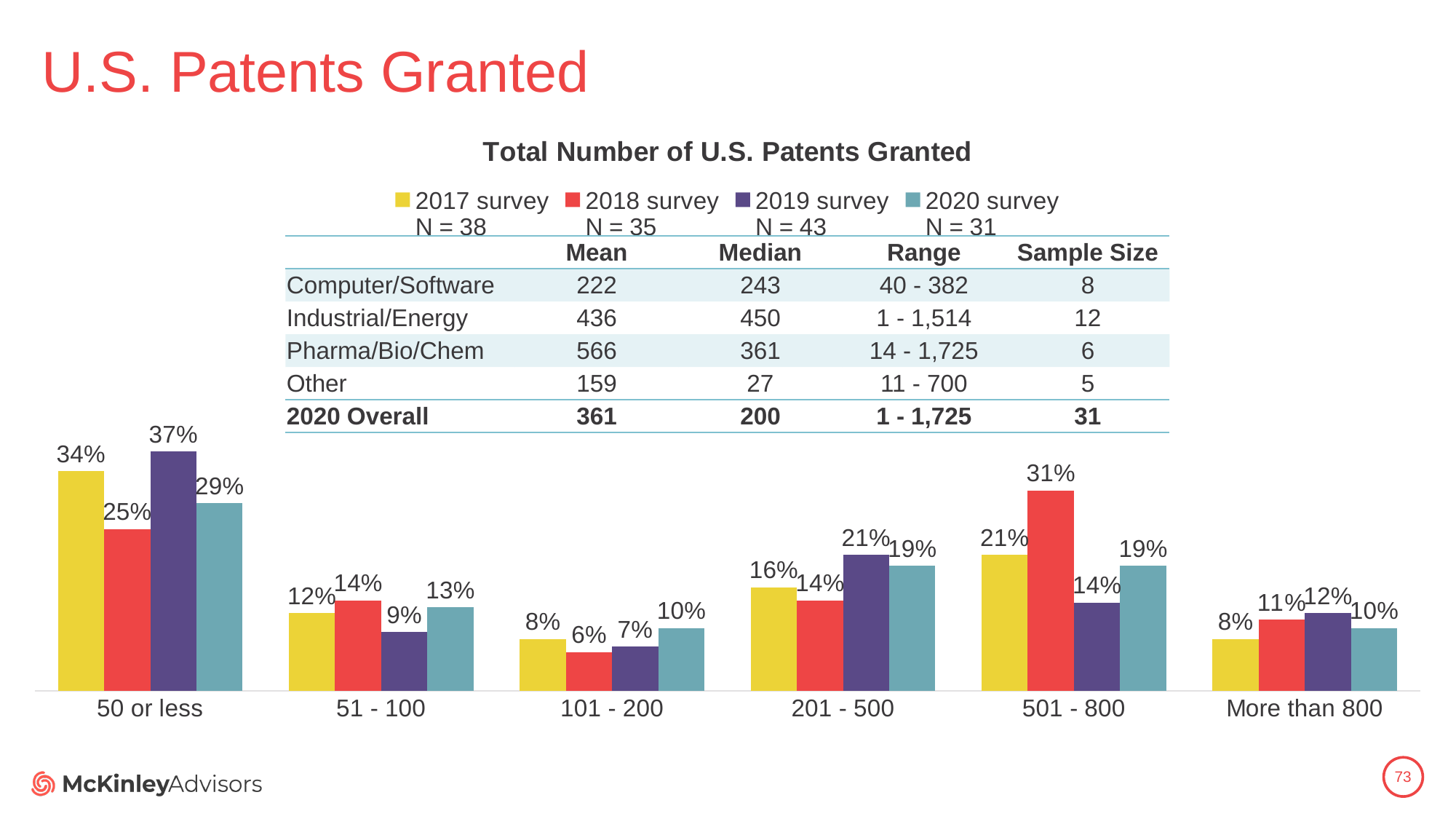
What is the sample size (N) shown in the legend for the 2020 survey? N = 31 Which category has the lowest value for the 2018 survey? 101 - 200 In the '201 - 500' category, which is larger: the 2019 survey value or the 2017 survey value? 2019 survey How many categories are shown along the x axis of the chart? 6 What is the value for the 2019 survey in the '50 or less' category? 37% What is the value for the 2020 survey in the '101 - 200' category? 10% Which category has the highest value for the 2017 survey? 50 or less What is the value for the 2018 survey in the '501 - 800' category? 31% What is the title of the chart? Total Number of U.S. Patents Granted How many series does the chart legend list? 4 What is the difference between the 2019 survey and 2018 survey values in the '50 or less' category? 12% What kind of chart is shown on the slide? bar chart